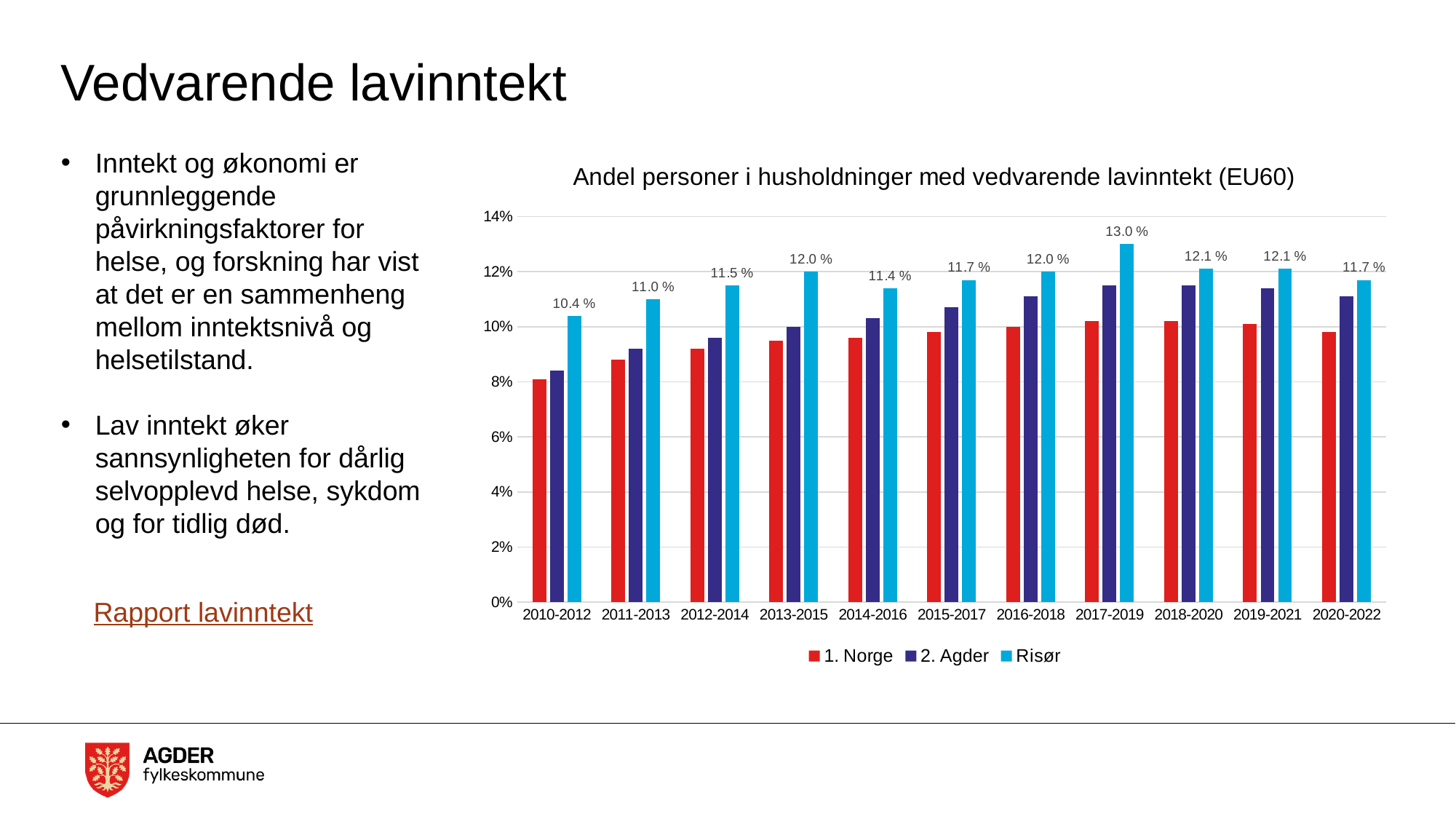
How many time periods are shown on the x axis? 11 Is the value for 2. Agder in 2017-2019 greater or less than 10%? greater What is the difference between the Risør values for 2017-2019 and 2010-2012? 2.6 percentage points In which period is the Risør value lowest? 2010-2012 In which period is the Risør value highest? 2017-2019 What is the value for Risør in 2017-2019? 13.0 % Is the value for 1. Norge in 2010-2012 greater or less than 10%? less What is the value for Risør in 2020-2022? 11.7 % What is the value for Risør in 2010-2012? 10.4 % What kind of chart is shown on the slide? Bar chart How many series does the legend list? 3 Which is larger in 2017-2019, the value for Risør or the value for 1. Norge? Risør